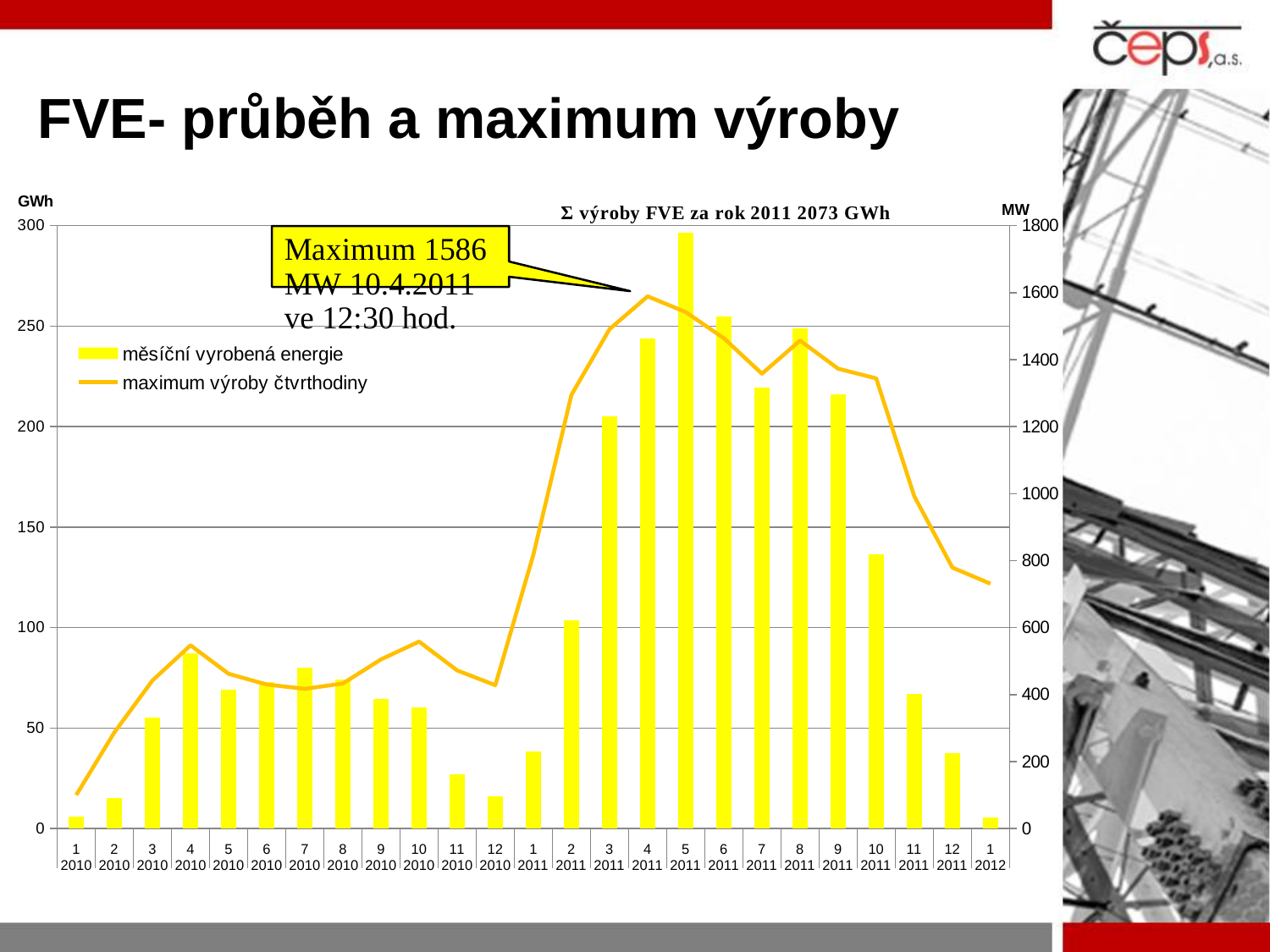
How many months (categories) are shown on the x axis? 25 How many series does the legend list? 2 Is the bar for 12 2010 greater or less than 50 GWh? less On what date was the maximum of 1586 MW reached according to the callout? 10.4.2011 Is the maximum výroby čtvrthodiny line value for 1 2012 greater or less than 800 MW? less What is the total FVE production for 2011 stated on the chart? 2073 GWh Do the bars rise or fall from 1 2011 to 5 2011? rise Is the bar for 5 2011 greater or less than 250 GWh? greater Which month has the highest bar for měsíční vyrobená energie? 5 2011 What is the maximum quarter-hour production value highlighted in the callout? 1586 MW Which bar is taller, 5 2011 or 8 2011? 5 2011 What kind of chart is shown on the slide? A combined bar and line chart